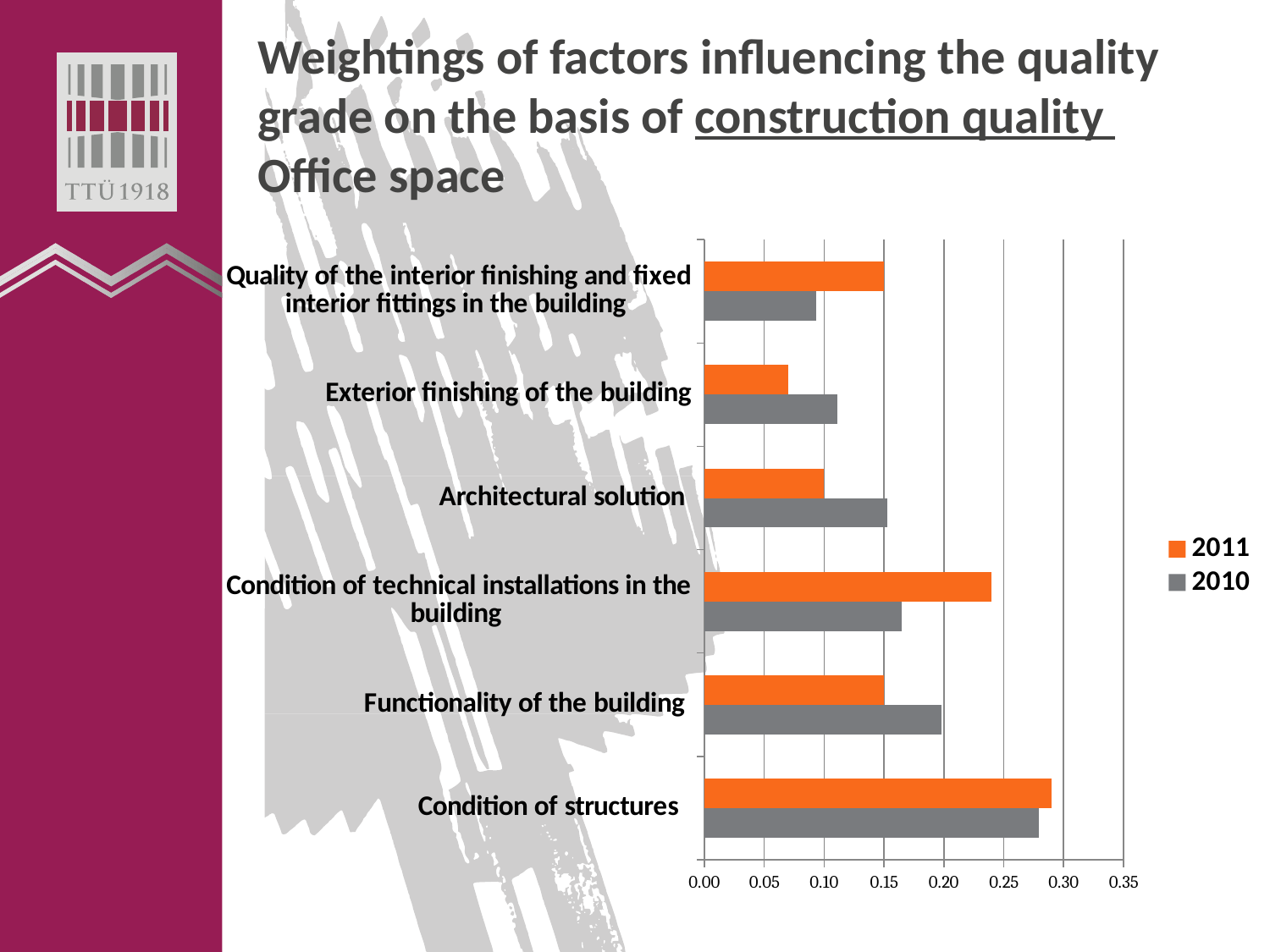
How many series does the legend list? 2 For Condition of technical installations in the building, which year has the larger weighting, 2011 or 2010? 2011 Which factor has the highest weighting for 2010? Condition of structures Is the 2011 value for Exterior finishing of the building greater or less than 0.10? less Which factor has the lowest weighting for 2010? Quality of the interior finishing and fixed interior fittings in the building Which factor has the lowest weighting for 2011? Exterior finishing of the building What colour represents the 2011 series in the legend? Orange What kind of chart is shown on the slide? Bar chart How many factor categories are plotted on the chart? 6 For Functionality of the building, which year has the larger weighting, 2011 or 2010? 2010 Which factor has the highest weighting for 2011? Condition of structures Is the 2011 value for Condition of technical installations in the building greater or less than 0.20? greater